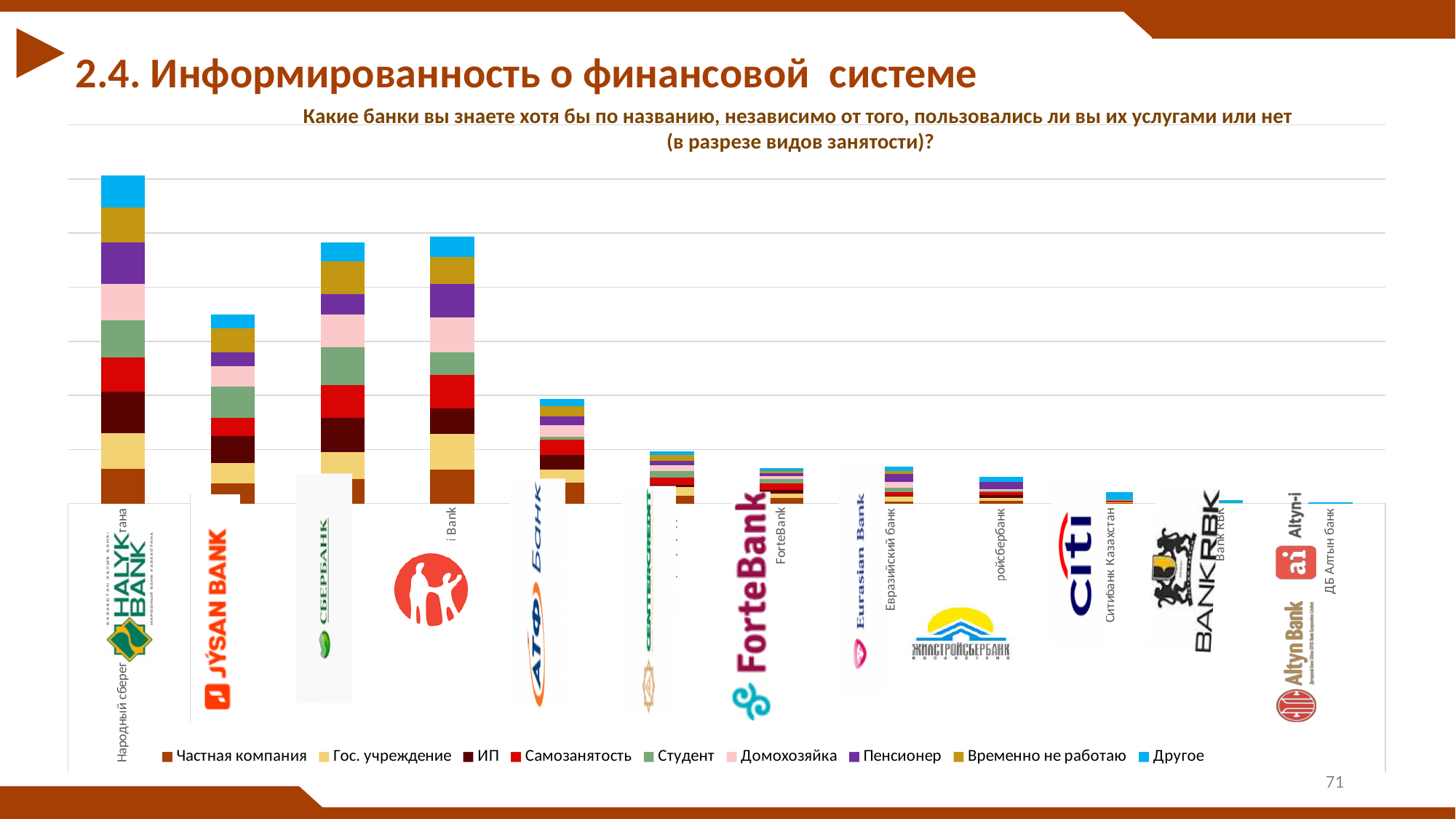
Which bar is taller: Сбербанк or Jysan Bank? Сбербанк Which bank has the shortest stacked bar? ДБ Алтын банк Which series is listed first in the legend? Частная компания Which series is shown in light blue at the top of each stacked bar? Другое How many series does the legend list? 9 Do the bar heights overall rise or fall from left to right across the chart? Fall Which bar is taller: Jysan Bank or АТФ банк? Jysan Bank How many banks (categories) are shown on the chart? 12 What kind of chart is shown on the slide? Stacked bar chart Which bank has the tallest stacked bar? Halyk Bank (Народный сберегательный банк) Which bar is taller: Жилстройсбербанк or Ситибанк Казахстан? Жилстройсбербанк